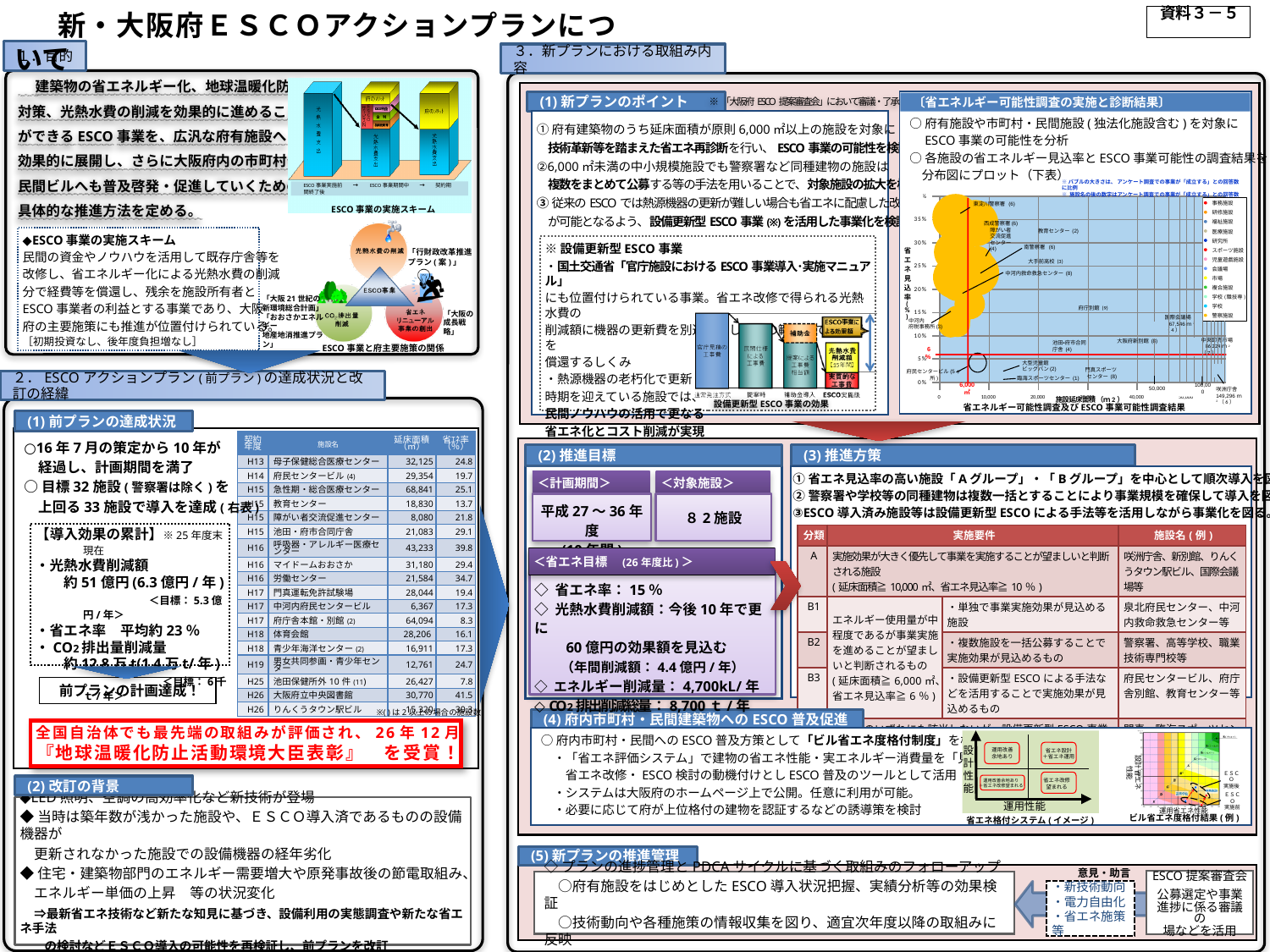
In the 省エネルギー可能性調査及びESCO事業可能性調査結果 chart, what floor area is printed for 咲洲庁舎? 149,296㎡ In the 省エネルギー可能性調査及びESCO事業可能性調査結果 chart, which has the higher 省エネ見込率, 東淀川警察署 or 咲洲庁舎? 東淀川警察署 What kind of chart is the 省エネルギー可能性調査及びESCO事業可能性調査結果 chart? bubble chart (scatter plot) In the 省エネルギー可能性調査及びESCO事業可能性調査結果 chart, is the 省エネ見込率 for 東淀川警察署 greater or less than 30%? greater In the 省エネルギー可能性調査及びESCO事業可能性調査結果 chart, is the 省エネ見込率 for 咲洲庁舎 greater or less than 10%? less In the 省エネルギー可能性調査及びESCO事業可能性調査結果 chart, what is the label of the vertical axis? 省エネ見込率 (%) In the 省エネルギー可能性調査及びESCO事業可能性調査結果 chart, what floor area is printed for 国際会議場? 67,586㎡ In the 省エネルギー可能性調査及びESCO事業可能性調査結果 chart, by how much does the floor area of 咲洲庁舎 exceed that of 国際会議場? 81,710㎡ In the 省エネルギー可能性調査及びESCO事業可能性調査結果 chart, which has the larger floor area, 国際会議場 or 咲洲庁舎? 咲洲庁舎 What kind of chart is the 設備更新型ESCO事業の効果 chart? bar chart In the 省エネルギー可能性調査及びESCO事業可能性調査結果 chart, what is the label of the horizontal axis? 施設延床面積 (㎡)